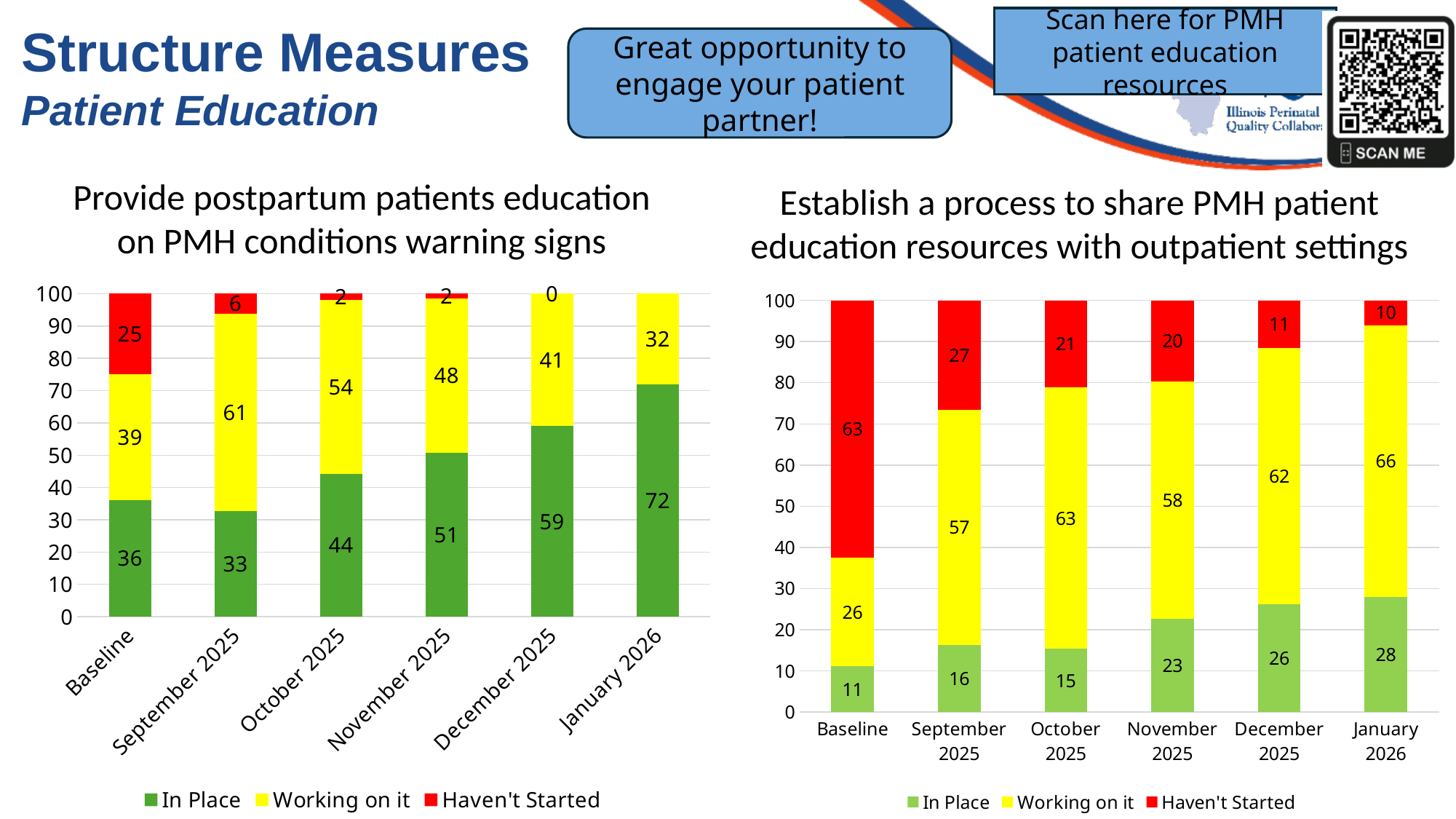
In the left chart (Provide postpartum patients education on PMH conditions warning signs), what is the Haven't Started value for Baseline? 25 In the right chart (Establish a process to share PMH patient education resources with outpatient settings), what is the difference between the In Place values for January 2026 and Baseline? 17 In the left chart (Provide postpartum patients education on PMH conditions warning signs), is the In Place value for December 2025 larger than the In Place value for November 2025? Yes, December 2025 (59) is larger than November 2025 (51) In the right chart (Establish a process to share PMH patient education resources with outpatient settings), which category has the highest Haven't Started value? Baseline In the left chart (Provide postpartum patients education on PMH conditions warning signs), which category has the lowest In Place value? September 2025 How many categories are shown on the x axis of the right chart (Establish a process to share PMH patient education resources with outpatient settings)? 6 In the right chart (Establish a process to share PMH patient education resources with outpatient settings), does the In Place value generally rise or fall from Baseline to January 2026? Rise In the right chart (Establish a process to share PMH patient education resources with outpatient settings), what is the Working on it value for October 2025? 63 How many series does the legend of the left chart (Provide postpartum patients education on PMH conditions warning signs) list? 3 What kind of chart is the right chart (Establish a process to share PMH patient education resources with outpatient settings)? Stacked bar chart In the left chart (Provide postpartum patients education on PMH conditions warning signs), what is the In Place value for January 2026? 72 In the right chart (Establish a process to share PMH patient education resources with outpatient settings), what is the total of the stacked bar for September 2025? 100